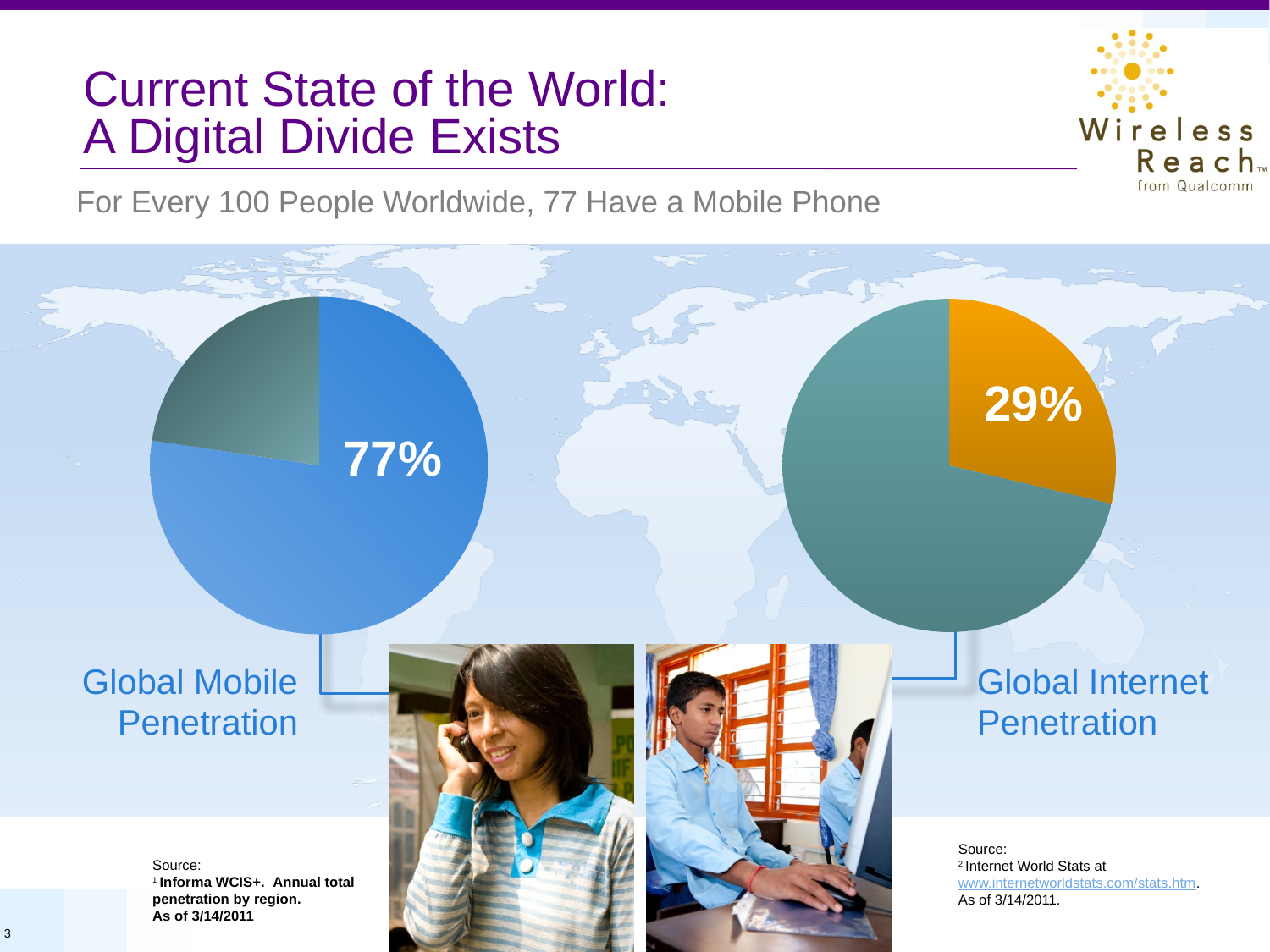
How many pie charts are shown on the slide? 2 What is the difference between the Global Mobile Penetration value and the Global Internet Penetration value? 48 percentage points What is the label of the pie chart on the left side of the slide? Global Mobile Penetration How many slices does the Global Mobile Penetration pie chart have? 2 What colour is the 29% slice in the Global Internet Penetration chart? Orange Which is larger, the Global Mobile Penetration value or the Global Internet Penetration value? Global Mobile Penetration What kind of chart is used for Global Internet Penetration? Pie chart How many slices does the Global Internet Penetration pie chart have? 2 In the Global Mobile Penetration chart, what percentage is shown on the highlighted slice? 77% In the Global Internet Penetration chart, what percentage is shown on the highlighted slice? 29% What kind of chart is used for Global Mobile Penetration? Pie chart